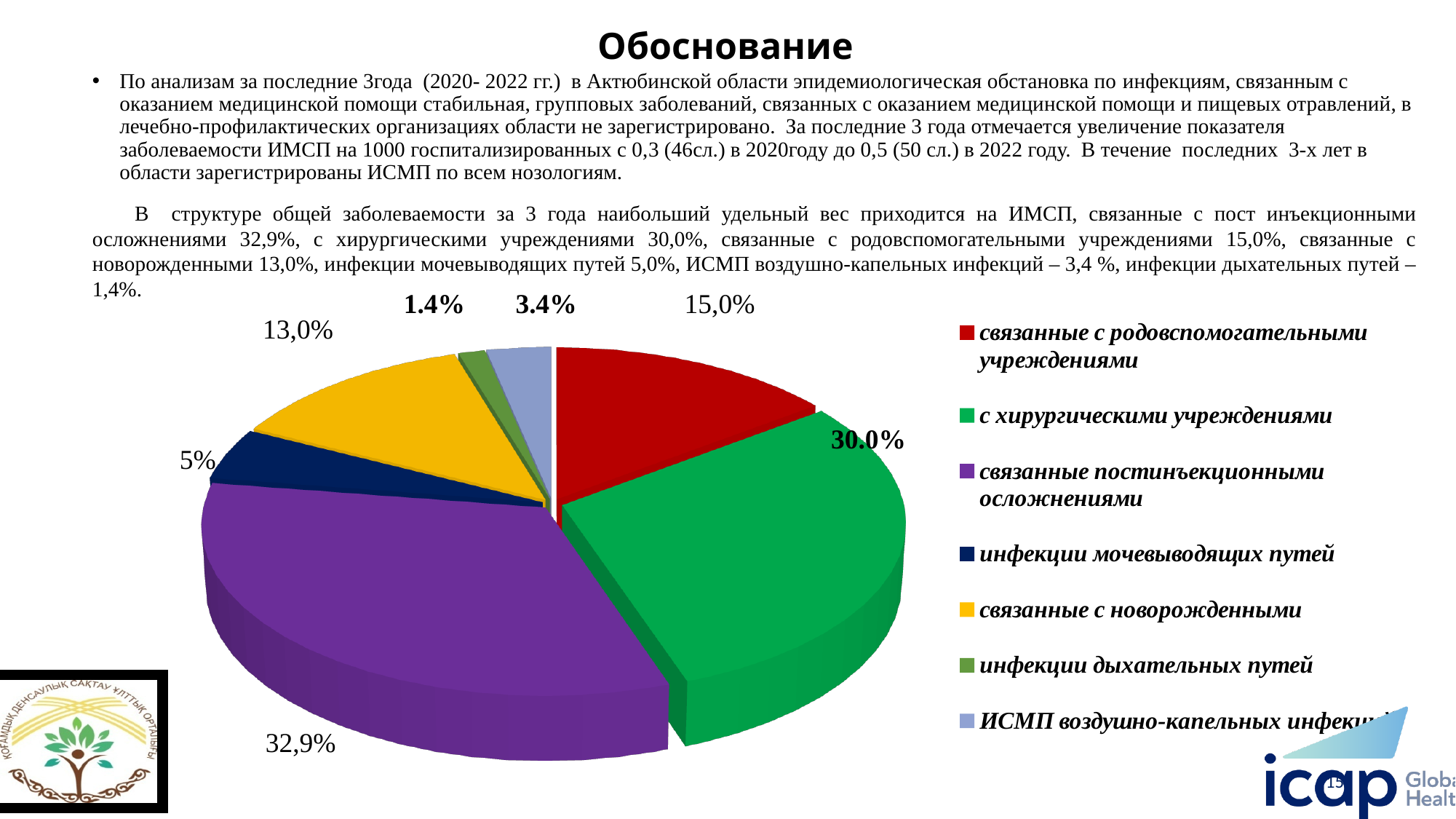
What type of chart is shown on the slide? pie chart What value is shown for 'связанные с родовспомогательными учреждениями'? 15,0% How many categories does the legend of the pie chart list? 7 What value is shown for 'связанные с новорожденными'? 13,0% What share of the pie is labelled for 'связанные постинъекционными осложнениями'? 32,9% Which category has the smallest slice of the pie? инфекции дыхательных путей What value is shown for the slice 'с хирургическими учреждениями'? 30.0% What value is shown for 'инфекции мочевыводящих путей'? 5% Which is larger: the slice for 'связанные с родовспомогательными учреждениями' or the slice for 'связанные с новорожденными'? связанные с родовспомогательными учреждениями Which category has the largest slice of the pie? связанные постинъекционными осложнениями What colour is the slice for 'с хирургическими учреждениями'? green What value is shown for 'инфекции дыхательных путей'? 1.4%